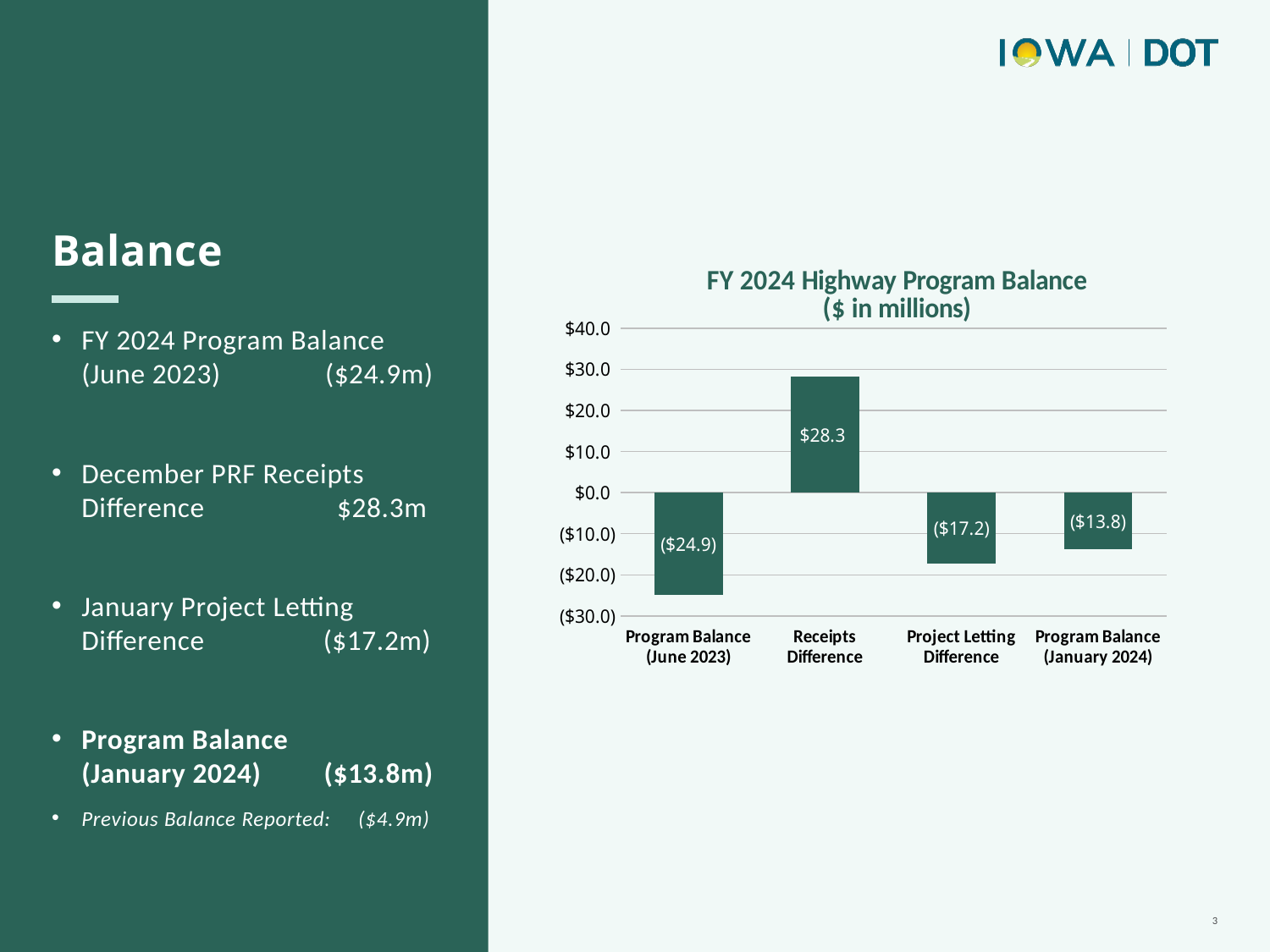
Which category has the lowest value? Program Balance (June 2023) Which is larger, the value for Project Letting Difference or the value for Program Balance (January 2024)? Program Balance (January 2024) What is the value for Program Balance (June 2023)? ($24.9) What is the value for Receipts Difference? $28.3 What is the value for Project Letting Difference? ($17.2) Which category has the highest value? Receipts Difference How many categories are shown on the x axis? 4 Is the value for Receipts Difference greater or less than $20.0? greater What kind of chart is this? bar chart What is the value for Program Balance (January 2024)? ($13.8) What is the title of the chart? FY 2024 Highway Program Balance ($ in millions) What is the difference between the value for Receipts Difference and the value for Program Balance (January 2024)? $42.1